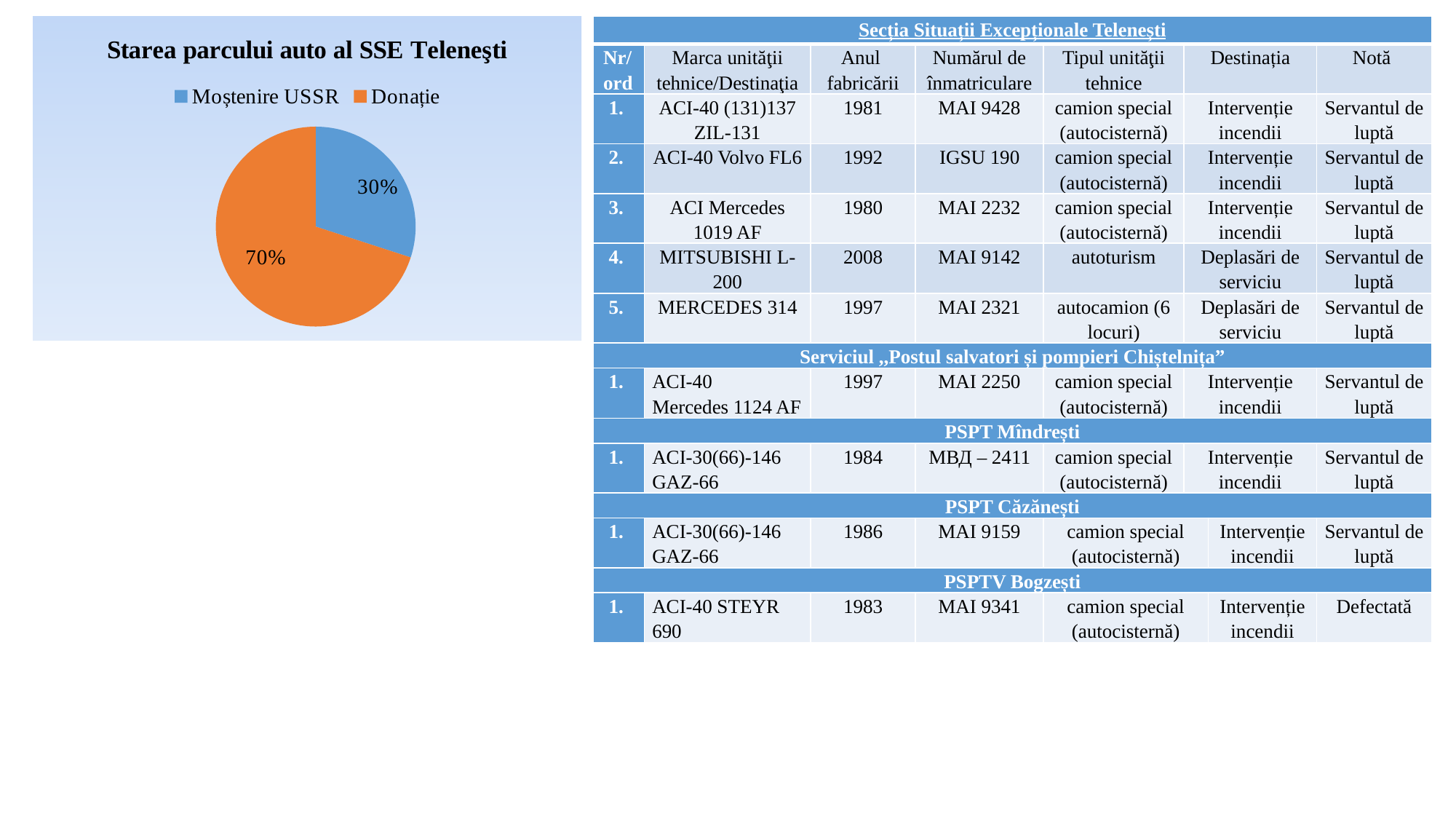
How many categories does the pie chart show? 2 Which is larger, the slice for Moștenire USSR or the slice for Donație? Donație What share of the pie does Moștenire USSR represent? 30% What is the difference in percentage points between Donație and Moștenire USSR? 40% How many entries does the legend list? 2 What kind of chart is shown on the slide? pie chart Which category has the smallest slice of the pie? Moștenire USSR Which category has the largest slice of the pie? Donație What is the title of the chart? Starea parcului auto al SSE Teleneşti What colour is the slice for Donație? orange What share of the pie does Donație represent? 70%